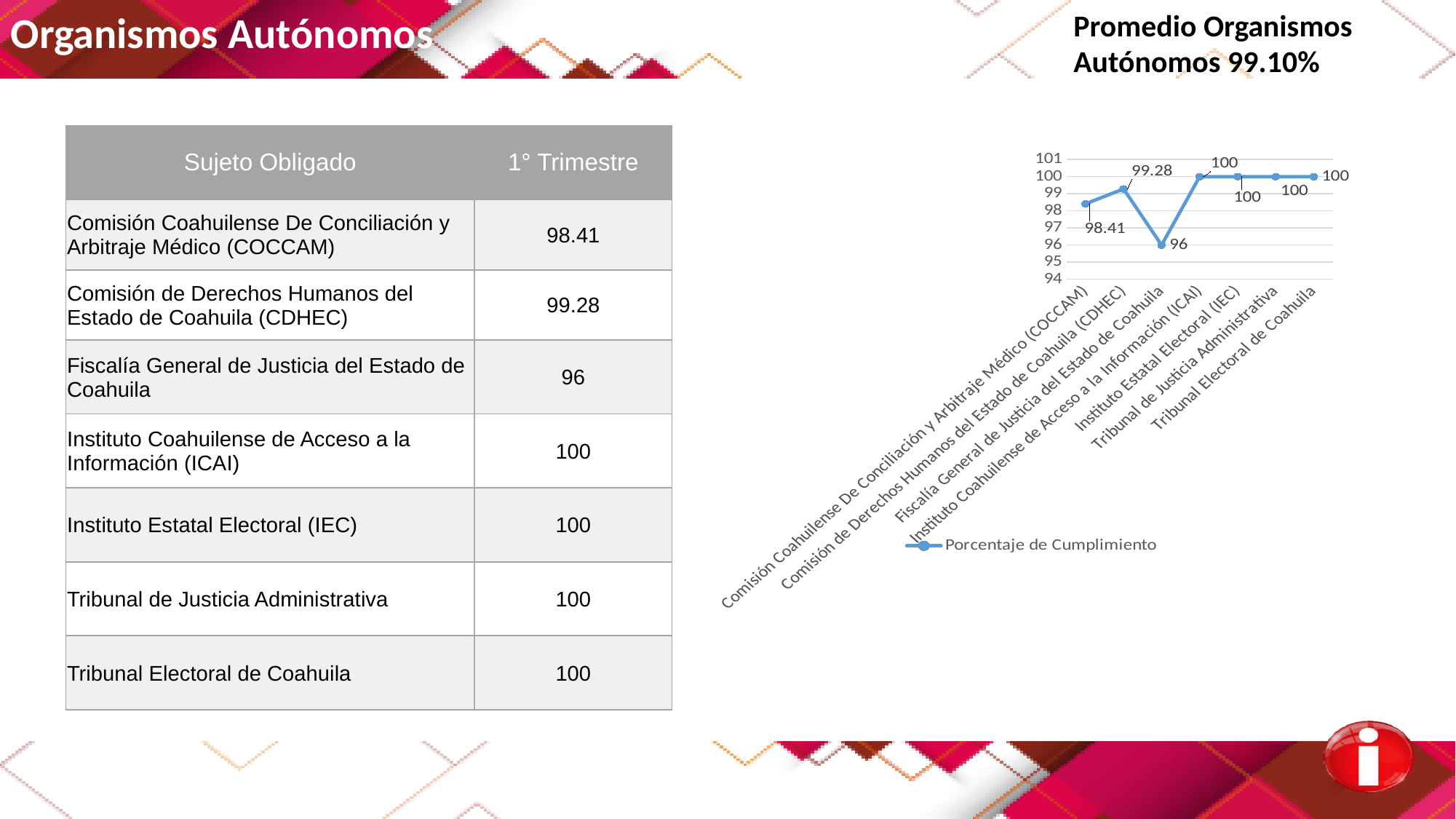
What is the name of the series shown in the chart legend? Porcentaje de Cumplimiento What is the value for Instituto Estatal Electoral (IEC) in the chart? 100 Which category has the lowest value in the chart? Fiscalía General de Justicia del Estado de Coahuila What is the value for Comisión de Derechos Humanos del Estado de Coahuila (CDHEC) in the chart? 99.28 What is the value for Fiscalía General de Justicia del Estado de Coahuila in the chart? 96 What kind of chart is shown on the slide? line chart What is the difference between the values for CDHEC and COCCAM in the chart? 0.87 Which is larger in the chart, the value for COCCAM or the value for CDHEC? CDHEC What is the value for Comisión Coahuilense De Conciliación y Arbitraje Médico (COCCAM) in the chart? 98.41 What is the difference between the value for Instituto Coahuilense de Acceso a la Información (ICAI) and the value for Fiscalía General de Justicia del Estado de Coahuila? 4 How many series does the chart legend list? 1 How many categories are plotted in the chart? 7